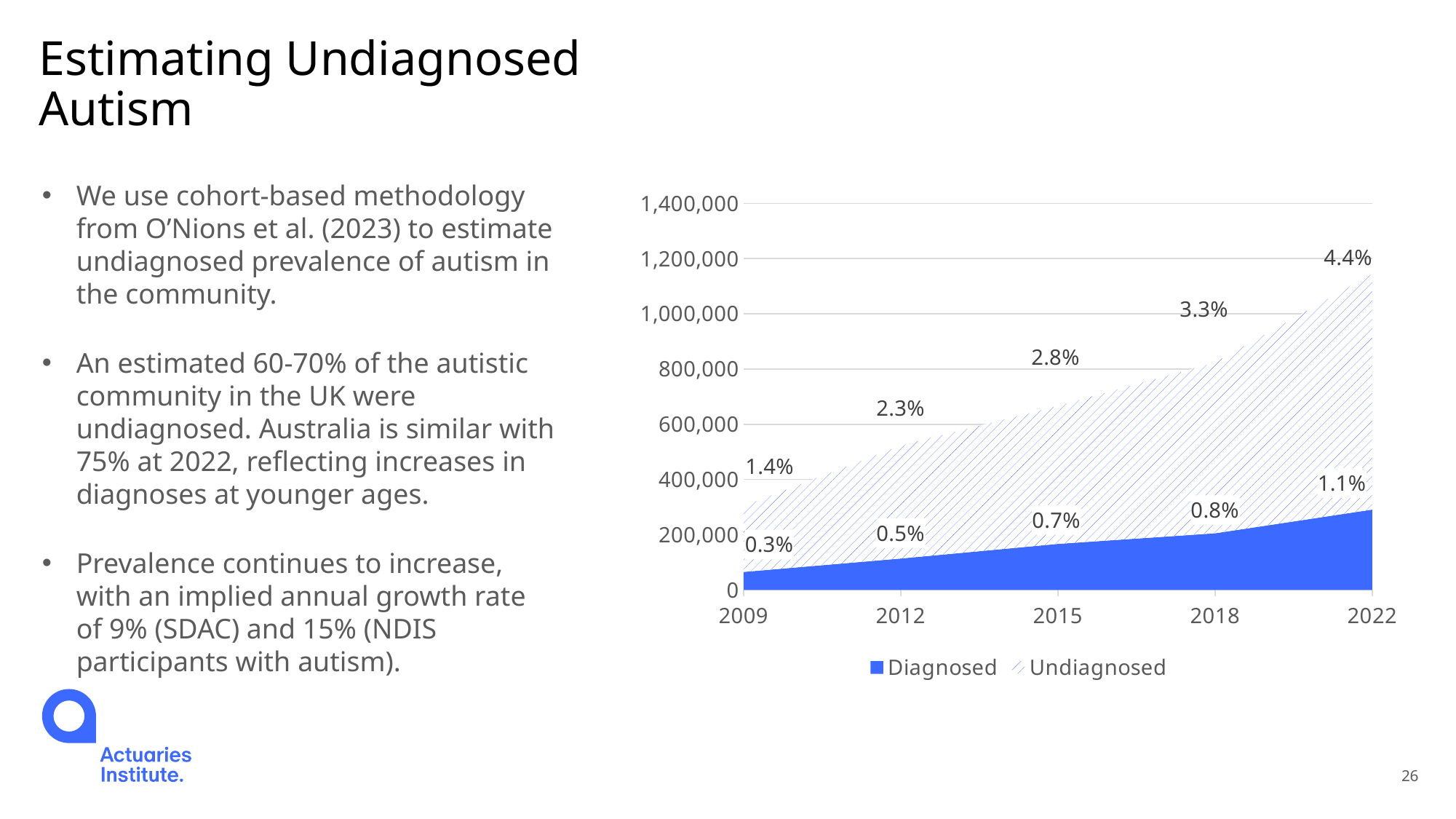
How many series does the chart legend list? 2 In which labelled year is the Undiagnosed data label highest? 2022 What is the Diagnosed data label shown for 2009? 0.3% What kind of chart is shown on the slide? Area chart What is the Undiagnosed data label shown for 2015? 2.8% What is the Undiagnosed data label shown for 2022? 4.4% Does the Diagnosed area rise or fall from 2009 to 2022? Rises Is the Diagnosed value for 2022 greater or less than 200,000? greater What is the difference between the Undiagnosed and Diagnosed data labels in 2022? 3.3% What is the Diagnosed data label shown for 2018? 0.8% In which labelled year is the Diagnosed data label lowest? 2009 What are the two series named in the chart legend? Diagnosed and Undiagnosed